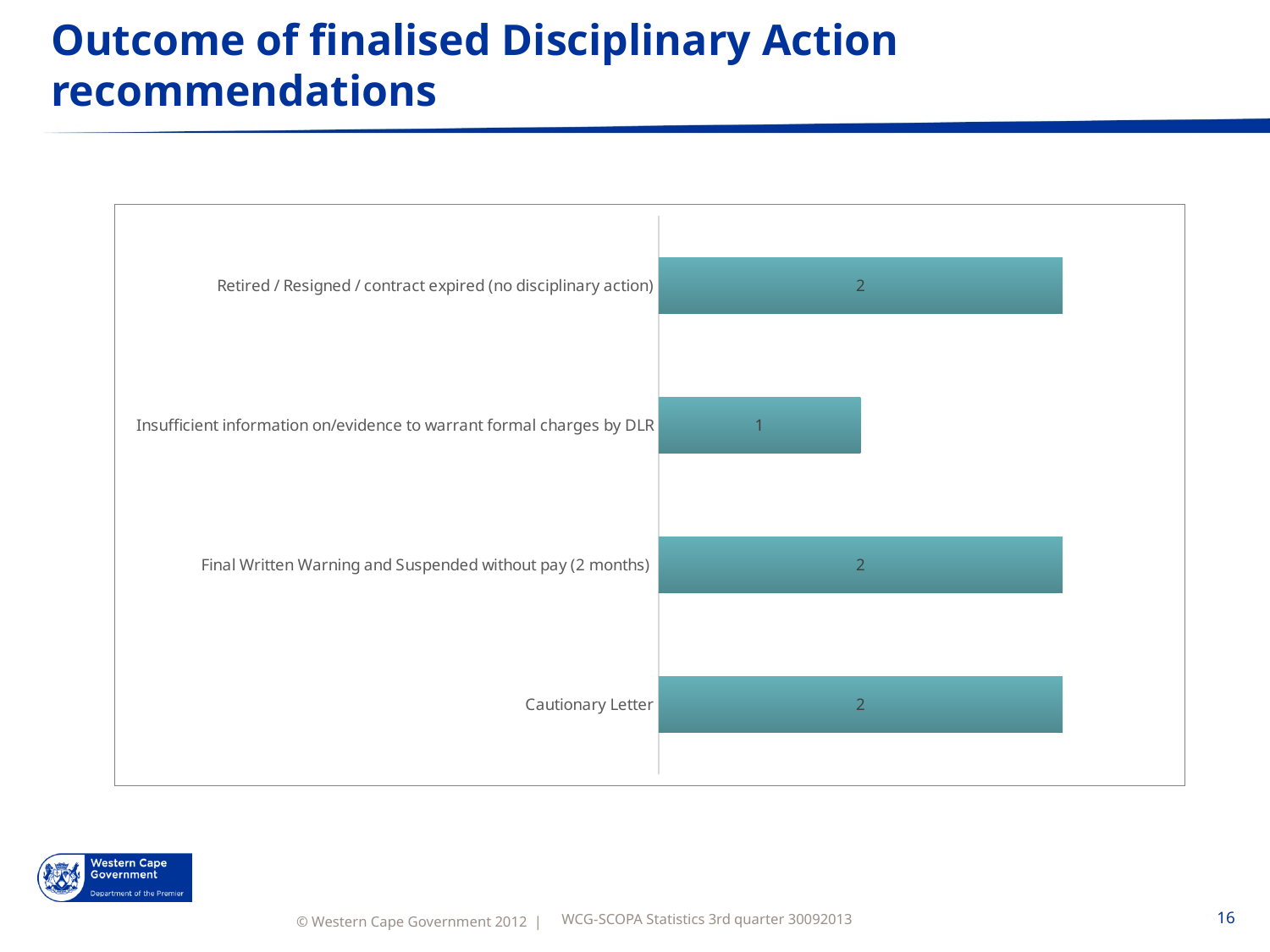
How many categories have a value of 2? 3 What is the value for Cautionary Letter? 2 How many categories are shown in the chart? 4 What is the total of all the values shown in the chart? 7 What is the title of the slide containing the chart? Outcome of finalised Disciplinary Action recommendations Which category has the lowest value? Insufficient information on/evidence to warrant formal charges by DLR Which is larger: the value for Retired / Resigned / contract expired (no disciplinary action) or the value for Insufficient information on/evidence to warrant formal charges by DLR? Retired / Resigned / contract expired (no disciplinary action) What is the difference between the value for Cautionary Letter and the value for Insufficient information on/evidence to warrant formal charges by DLR? 1 What kind of chart is shown on the slide? Bar chart What is the value for Insufficient information on/evidence to warrant formal charges by DLR? 1 What is the value for Final Written Warning and Suspended without pay (2 months)? 2 What is the value for Retired / Resigned / contract expired (no disciplinary action)? 2